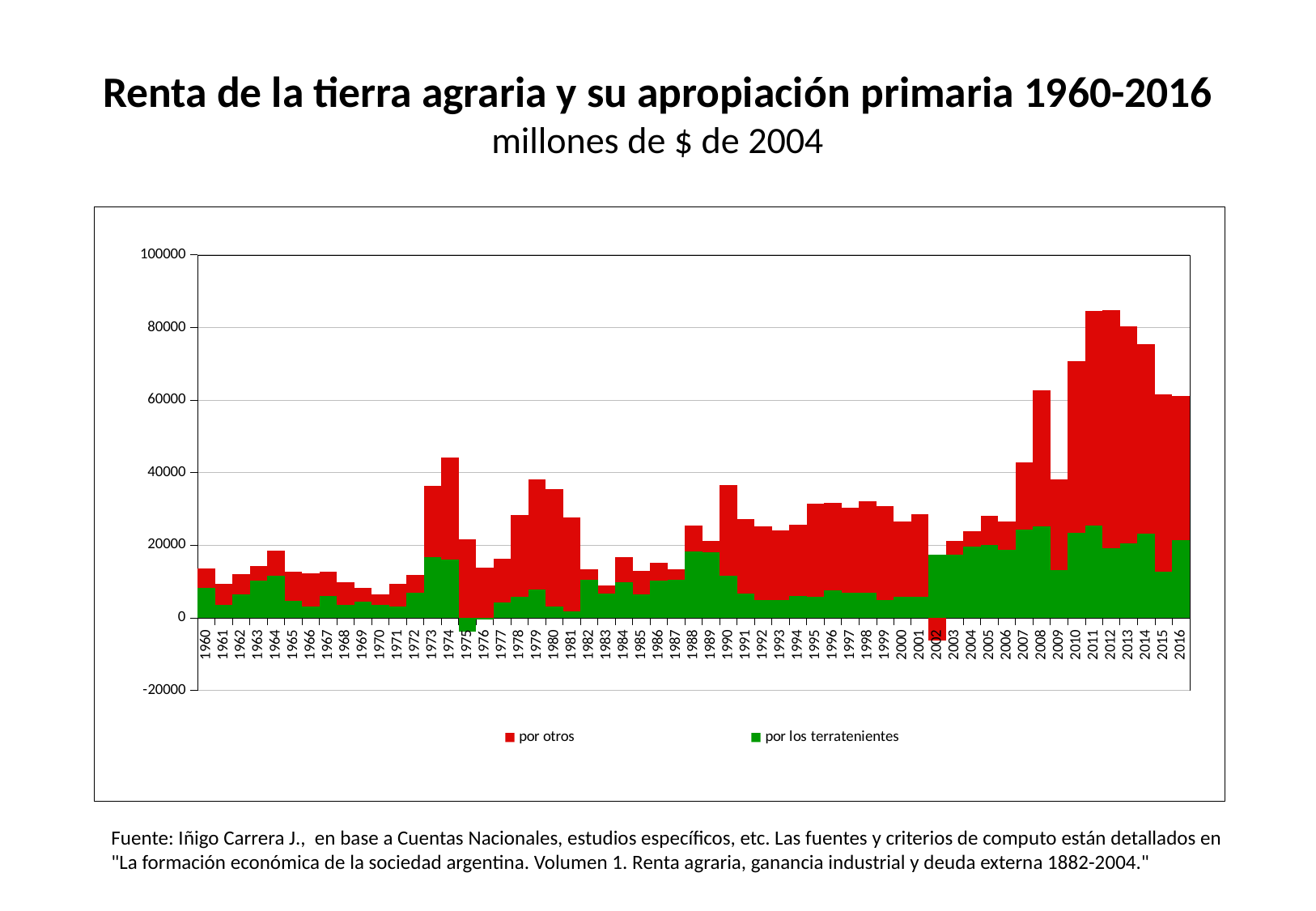
How many series does the legend list? 2 What kind of chart is shown on the slide? stacked bar chart Which year has the larger total, 2008 or 2007? 2008 Which colour represents the series 'por los terratenientes'? green Is the total value for 1960 greater or less than 20000? less Is the value for 'por los terratenientes' in 2011 greater or less than 20000? greater How many years (categories) are plotted along the x axis? 57 What are the two series named in the legend? por otros; por los terratenientes Is the total value for 2010 greater or less than 60000? greater Which year has the larger total, 1974 or 1979? 1974 Which year is the only one where the 'por otros' series is negative (below 0)? 2002